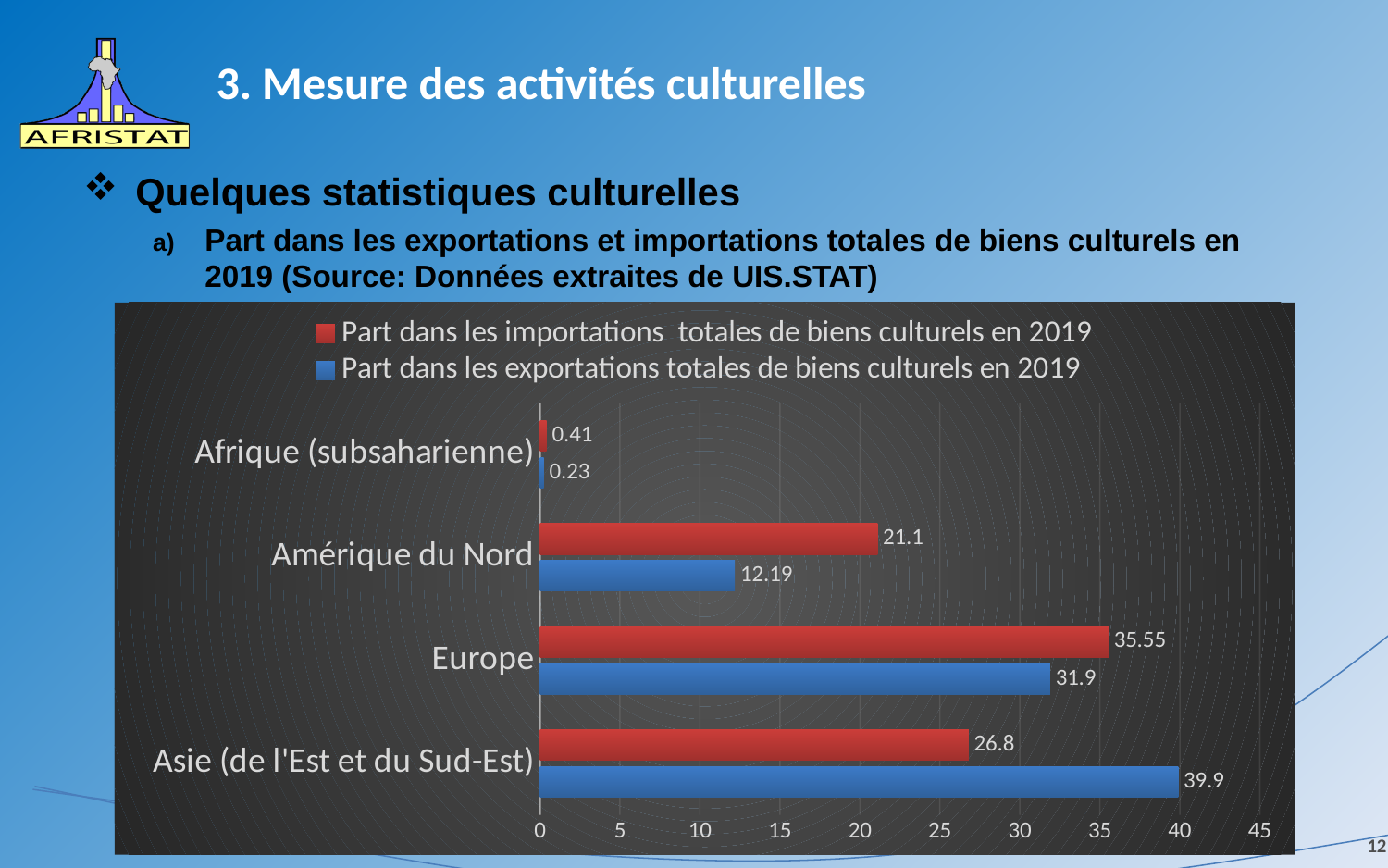
What is the share of total cultural goods imports in 2019 for Afrique (subsaharienne)? 0.41 Is the export share for Europe greater or less than 30? greater What type of chart is shown on the slide? bar chart How many series does the legend list? 2 How many regions are shown in the chart? 4 What is the share of total cultural goods exports in 2019 for Amérique du Nord? 12.19 Which region has the highest share of total cultural goods exports in 2019? Asie (de l'Est et du Sud-Est) What is the difference between the import share and the export share for Amérique du Nord? 8.91 Which region has the lowest share of total cultural goods imports in 2019? Afrique (subsaharienne) For Asie (de l'Est et du Sud-Est), which is larger: the share of imports or the share of exports? exports What is the share of total cultural goods exports in 2019 for Asie (de l'Est et du Sud-Est)? 39.9 What is the share of total cultural goods imports in 2019 for Europe? 35.55